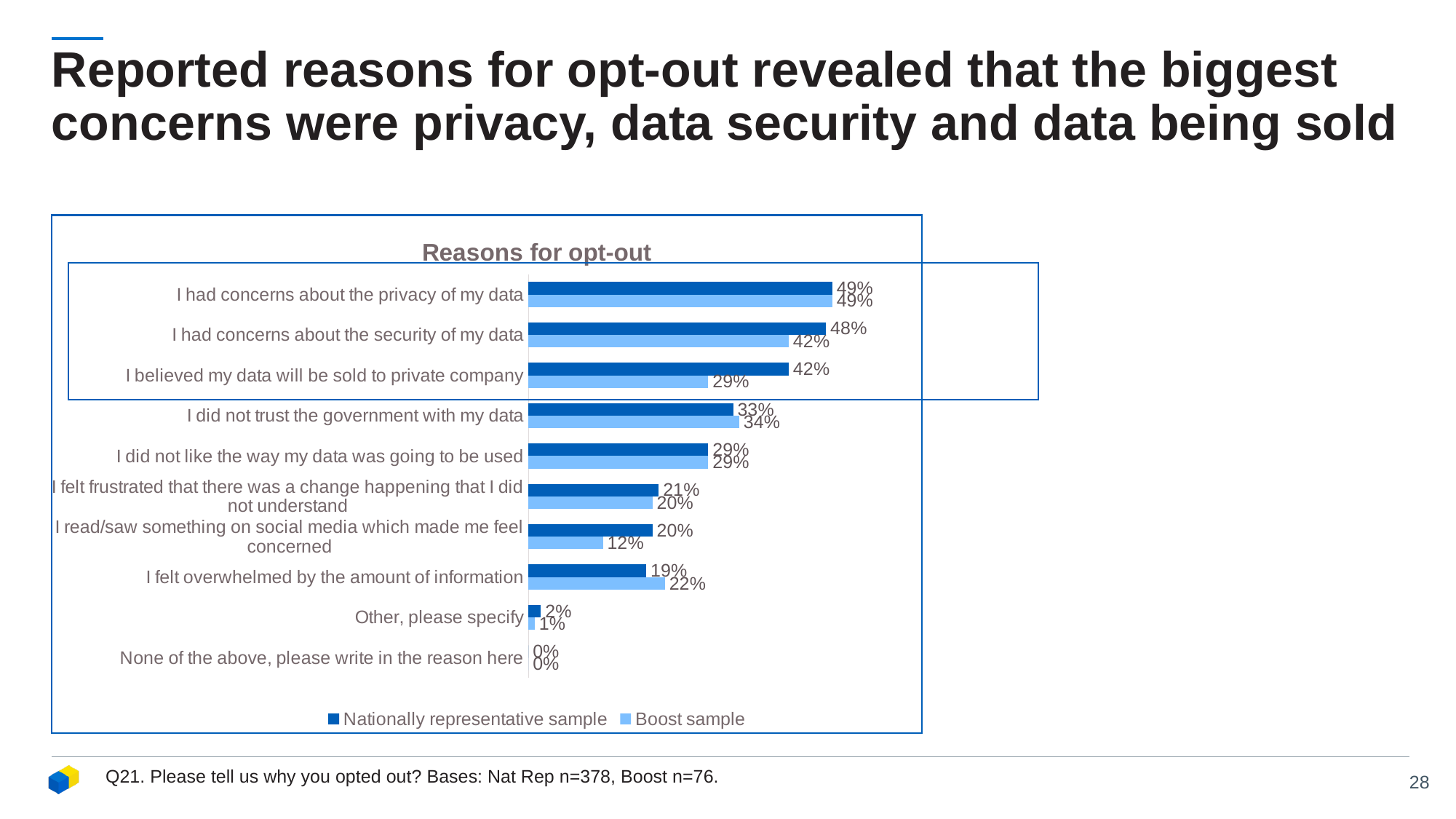
What is the Boost sample value for 'I believed my data will be sold to private company'? 29% What type of chart is shown on the slide? Bar chart For 'I felt overwhelmed by the amount of information', which is larger: the Nationally representative sample or the Boost sample value? Boost sample What is the difference between the Nationally representative sample and Boost sample values for 'I believed my data will be sold to private company'? 13 percentage points How many reasons (categories) are shown in the chart? 10 What is the Nationally representative sample value for 'I had concerns about the security of my data'? 48% Which reason has the highest Nationally representative sample value? I had concerns about the privacy of my data Which series is shown in the lighter blue colour? Boost sample Which reason has the lowest Boost sample value? None of the above, please write in the reason here What is the title of the chart? Reasons for opt-out How many series does the legend list? 2 What is the Boost sample value for 'I read/saw something on social media which made me feel concerned'? 12%